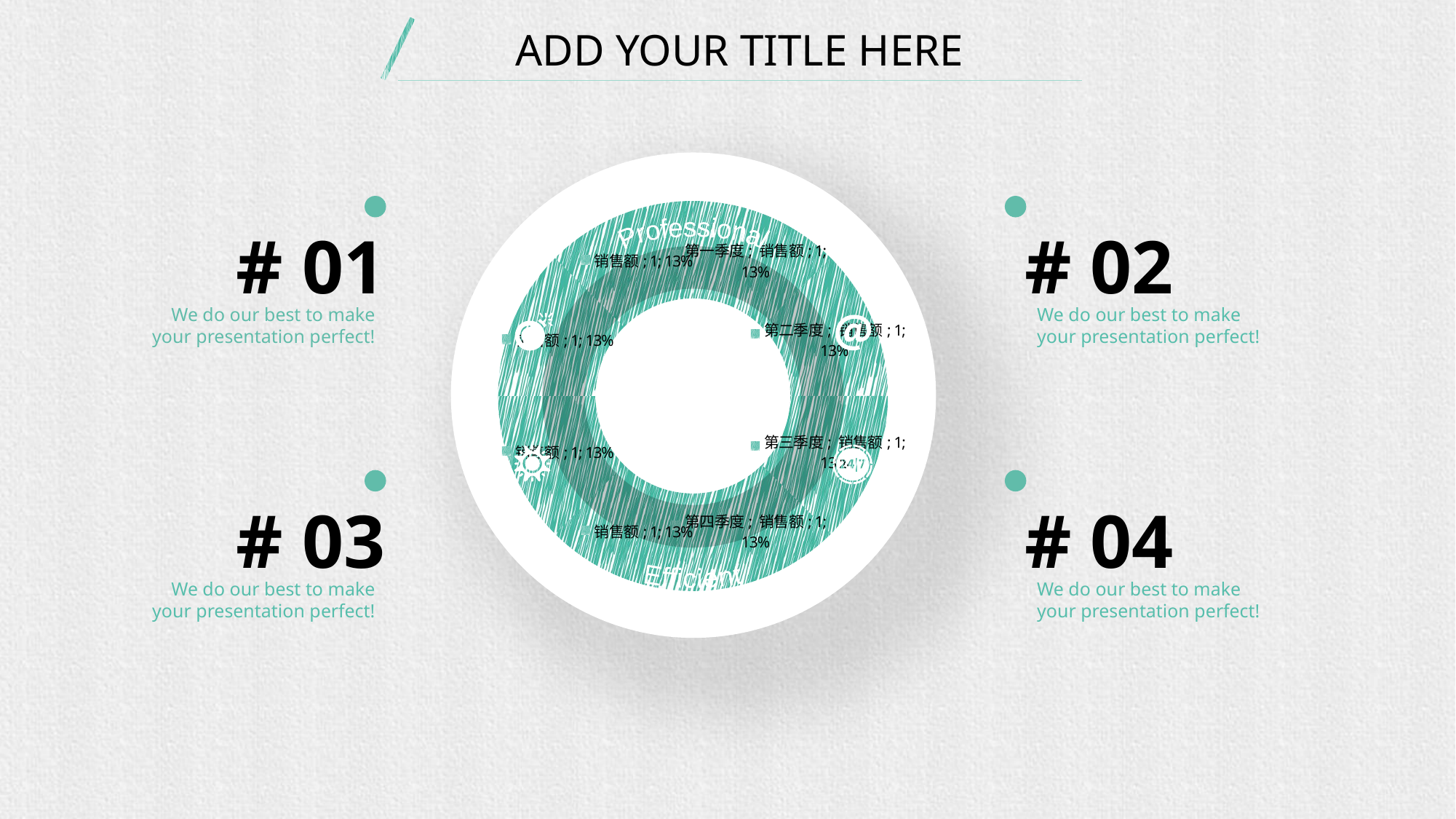
What is the name of the data series shown in the doughnut chart's data labels? 销售额 What value is printed for 第一季度 in the doughnut chart? 1 What percentage share is shown for 第一季度 in the doughnut chart? 13% What value is printed for 第四季度 in the doughnut chart? 1 What percentage share is shown for 第三季度 in the doughnut chart? 13% What percentage share is shown for 第二季度 in the doughnut chart? 13% What is the main colour of the slices in the doughnut chart? Teal green What kind of chart is shown in the centre of the slide? Doughnut (pie) chart What value is printed for 第二季度 in the doughnut chart? 1 What is the difference between the values printed for 第一季度 and 第三季度 in the doughnut chart? 0